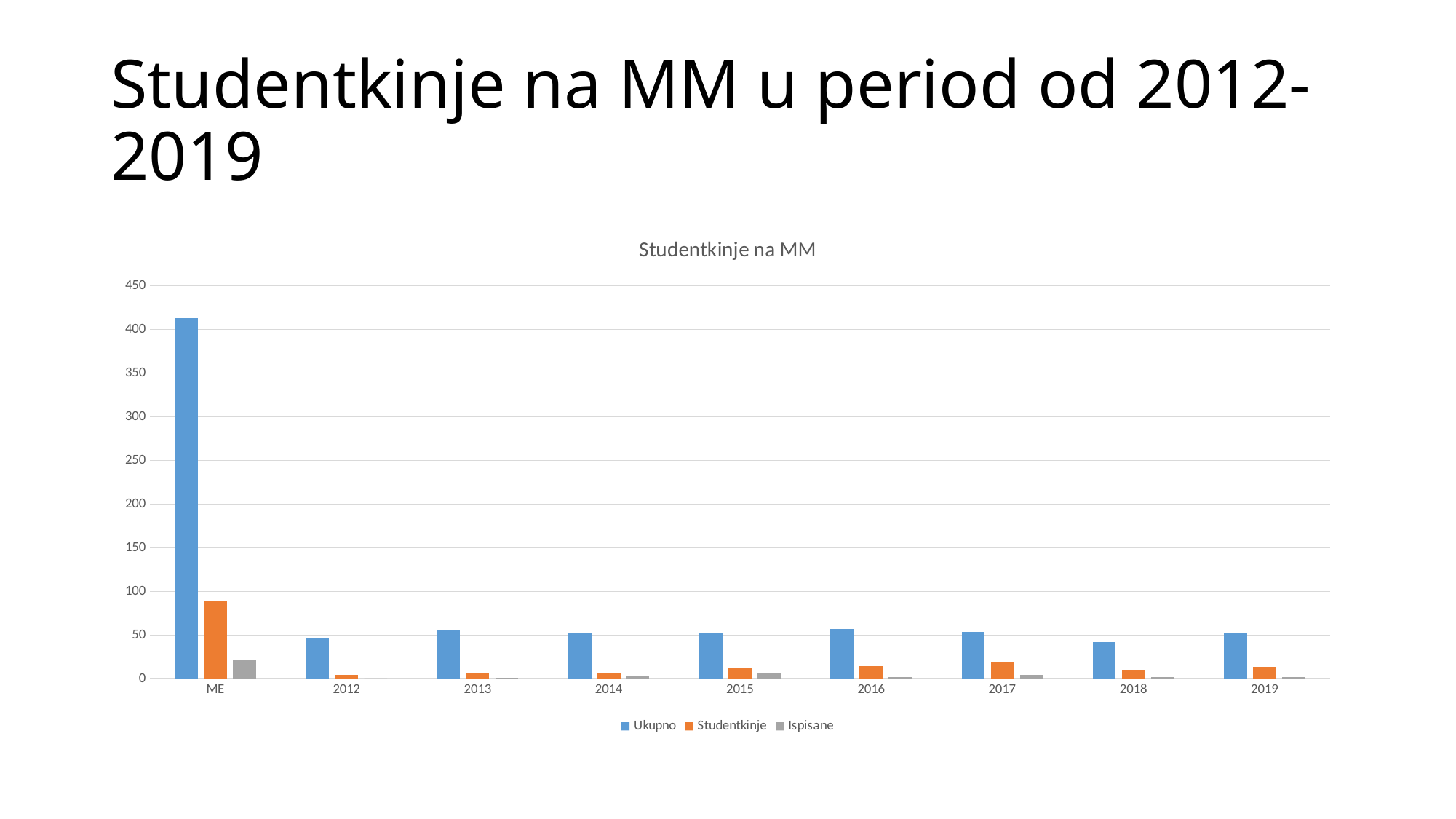
How many categories are shown on the x axis? 9 Is the Studentkinje value for ME greater or less than 100? less Which is larger, the Studentkinje value for 2012 or for 2017? 2017 Is the Ukupno value for 2016 greater or less than 50? greater Is the Ukupno value for ME greater or less than 400? greater Which is larger, the Ukupno value for 2016 or for 2018? 2016 Which category has the highest Ukupno value? ME What kind of chart is shown on the slide? bar chart What is the title of the chart? Studentkinje na MM Which series is shown in orange? Studentkinje How many series does the legend list? 3